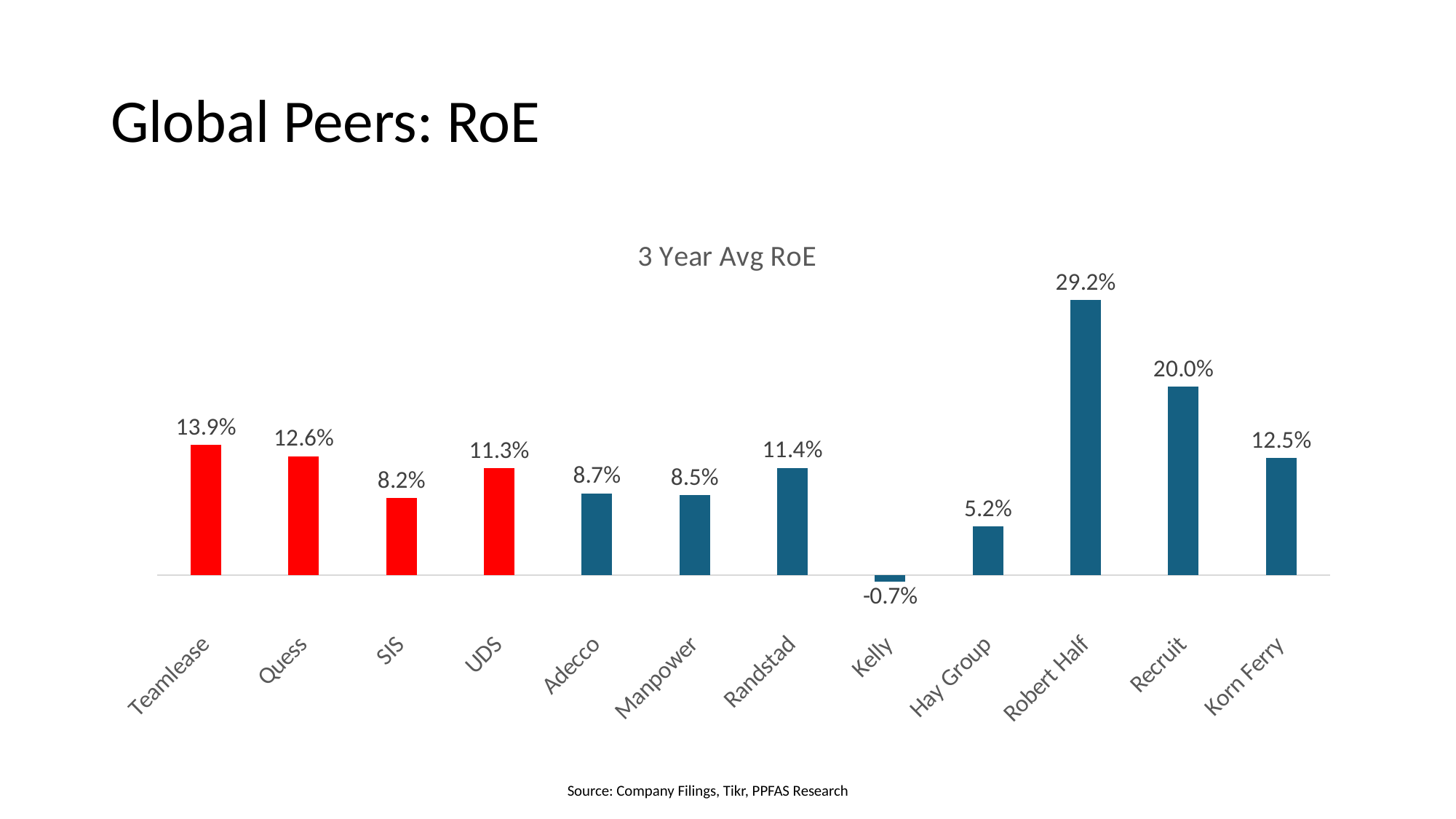
What is the title of the chart? 3 Year Avg RoE Which has a higher 3 Year Avg RoE, UDS or SIS? UDS Which has a higher 3 Year Avg RoE, Randstad or Hay Group? Randstad What is the 3 Year Avg RoE for Robert Half? 29.2% Which company has the lowest 3 Year Avg RoE? Kelly What type of chart is shown on the slide? Bar chart What is the 3 Year Avg RoE for Kelly? -0.7% What is the difference between the 3 Year Avg RoE of Teamlease and Quess? 1.3% What is the 3 Year Avg RoE for Teamlease? 13.9% What is the difference between the 3 Year Avg RoE of Robert Half and Recruit? 9.2% Which company has the highest 3 Year Avg RoE? Robert Half How many companies are shown in the chart? 12